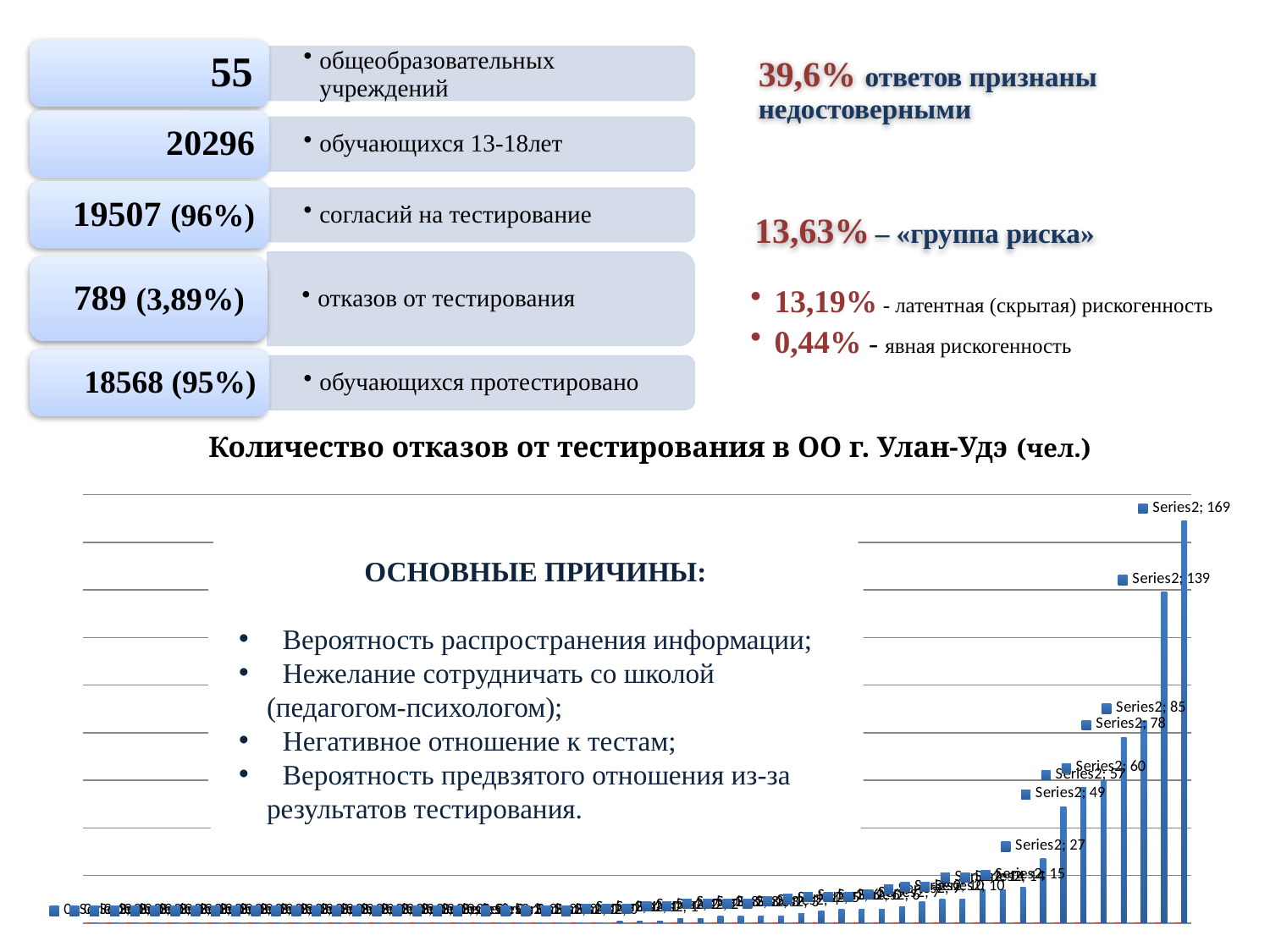
What is the value of the tallest bar in the chart? 169 Which is larger, the bar labelled 27 or the bar labelled 15? 27 What is the difference between the two tallest bars in the chart (169 and 139)? 30 What is the value of the bar labelled just below the bar with value 60? 57 What kind of chart is shown at the bottom of the slide? bar chart What is the difference between the bars labelled 60 and 49? 11 What is the title of the chart on the slide? Количество отказов от тестирования в ОО г. Улан-Удэ (чел.) What series name appears in the data labels of the chart? Series2 Do the bar values rise or fall from left to right along the x axis? rise Which is larger, the bar labelled 85 or the bar labelled 78? 85 What is the value of the second-tallest bar in the chart? 139